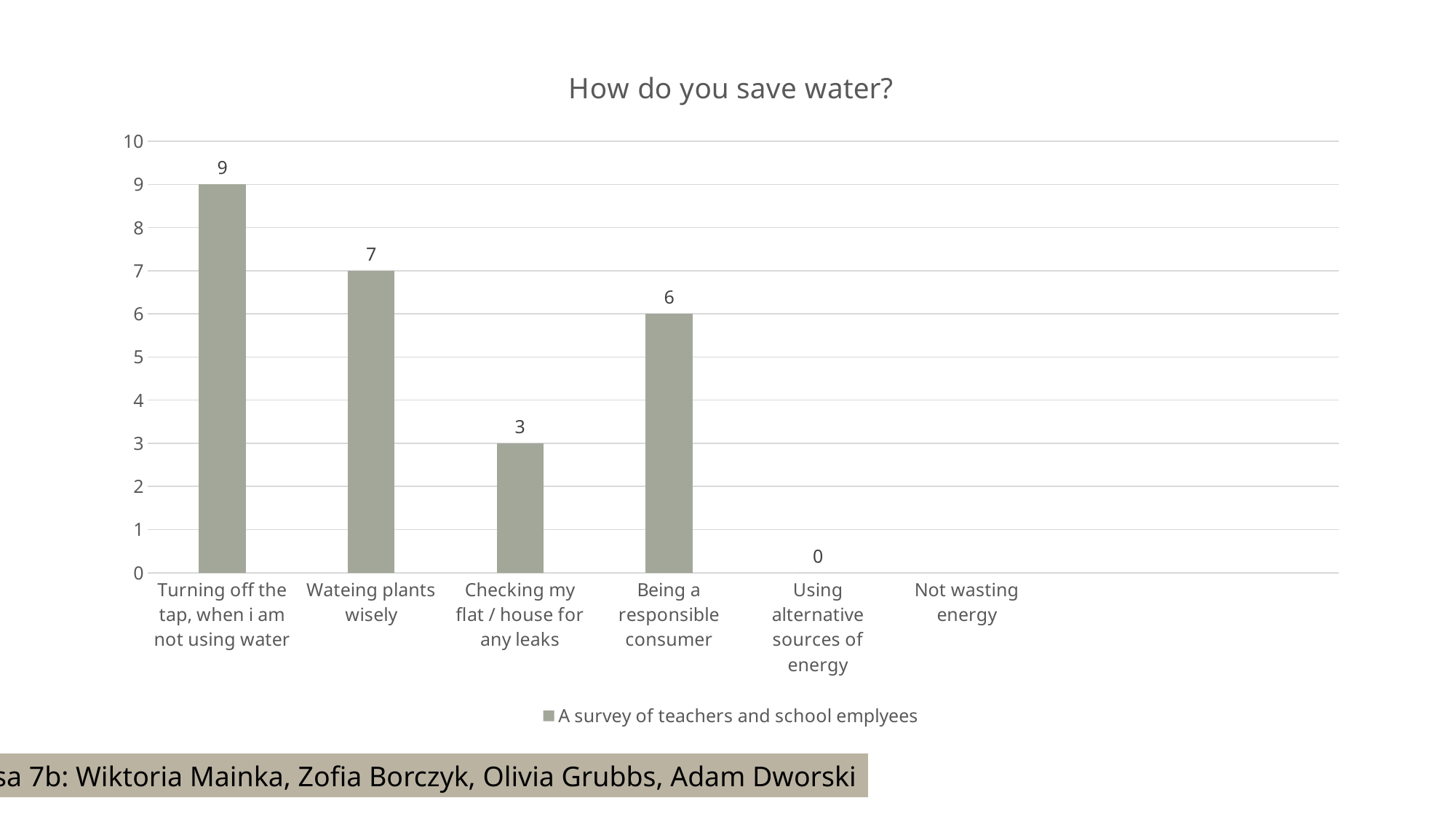
What is the value for "Using alternative sources of energy"? 0 How many series does the legend list? 1 Which is larger, the value for "Wateing plants wisely" or the value for "Being a responsible consumer"? Wateing plants wisely What is the value for "Wateing plants wisely"? 7 What is the value for "Checking my flat / house for any leaks"? 3 What is the difference between the values for "Being a responsible consumer" and "Checking my flat / house for any leaks"? 3 What is the value for "Being a responsible consumer"? 6 What is the value for "Turning off the tap, when i am not using water"? 9 What kind of chart is shown on the slide? Bar chart What is the difference between the values for "Turning off the tap, when i am not using water" and "Wateing plants wisely"? 2 Which category has the highest value? Turning off the tap, when i am not using water How many categories are shown on the x axis? 6